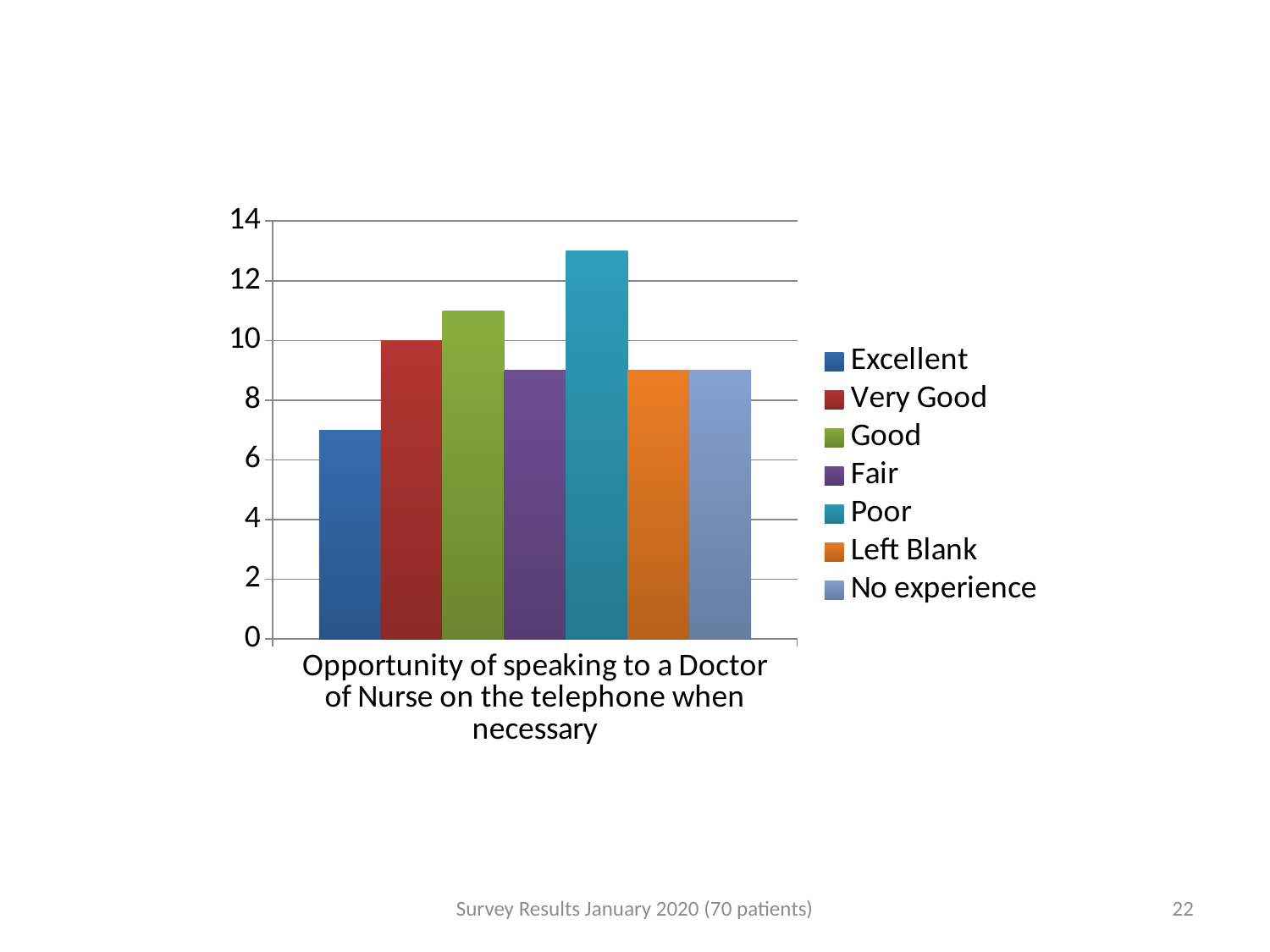
Is the value for Fair greater or less than 10? less Which is larger, the value for Good or the value for Fair? Good Which series has the highest bar? Poor What is the value for Very Good? 10 Is the value for Poor greater or less than 12? greater What is the category label shown on the x axis? Opportunity of speaking to a Doctor of Nurse on the telephone when necessary How many series does the legend list? 7 Which is larger, the value for Poor or the value for Very Good? Poor Which series has the lowest bar? Excellent What kind of chart is shown on the slide? Bar chart Is the value for Good greater or less than 10? greater